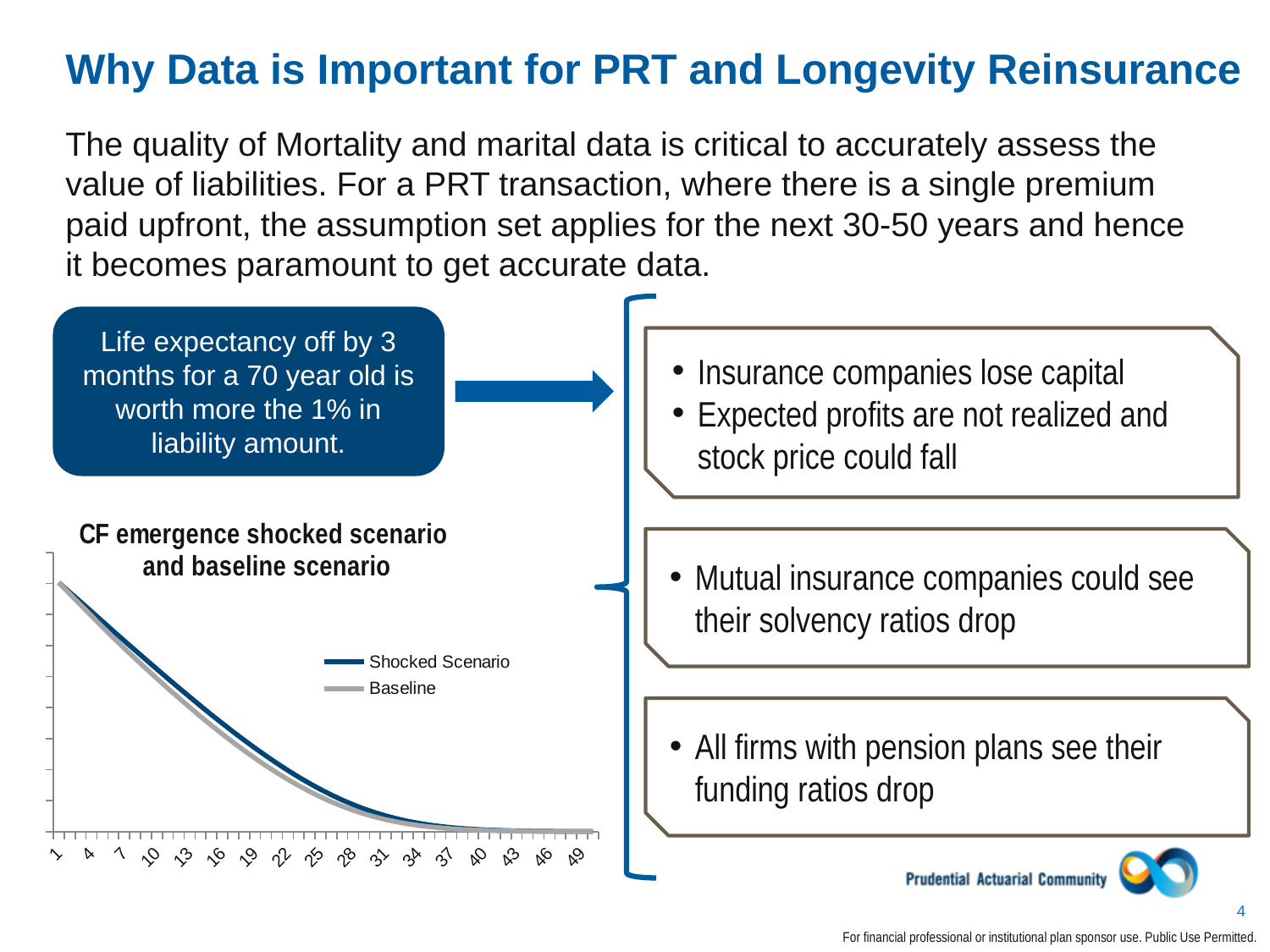
Do the values of the Baseline line rise or fall as you move along the x axis? fall What is the title of the chart? CF emergence shocked scenario and baseline scenario At x = 19, which series has the higher value, Shocked Scenario or Baseline? Shocked Scenario At x = 10, which series has the lower value, Shocked Scenario or Baseline? Baseline How many tick labels are shown on the chart's x axis? 17 What is the first tick label on the chart's x axis? 1 What is the last tick label on the chart's x axis? 49 What are the two series named in the chart's legend? Shocked Scenario and Baseline What kind of chart is shown on the slide? line chart How many series does the chart's legend list? 2 Do the values of the Shocked Scenario line rise or fall as you move along the x axis? fall